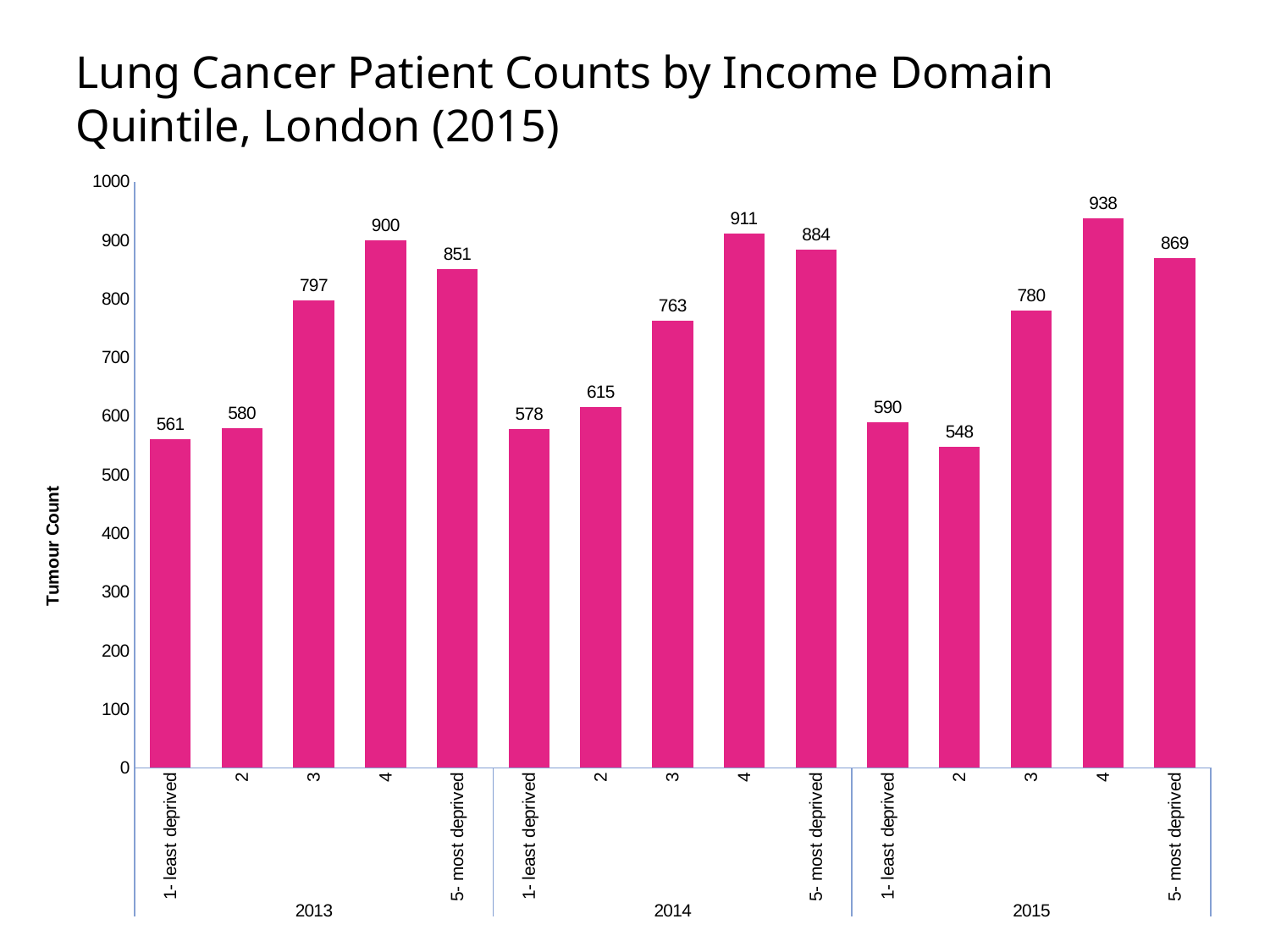
Which bar has the lowest tumour count on the chart? 2 (2015) Which is larger: the tumour count for 5- most deprived in 2013 or in 2015? 2015 Is the tumour count for 1- least deprived in 2014 greater or less than 600? less What is the label of the vertical axis? Tumour Count How many bars are plotted on the chart? 15 What kind of chart is shown on the slide? bar chart What is the difference between the tumour counts for quintile 4 and quintile 3 in 2014? 148 What is the tumour count for quintile 4 in 2013? 900 Within 2014, do the tumour counts rise or fall from quintile 1 to quintile 4? rise What is the tumour count for 5- most deprived in 2014? 884 Which bar has the highest tumour count on the chart? 4 (2015) What is the tumour count for quintile 2 (2015)? 548